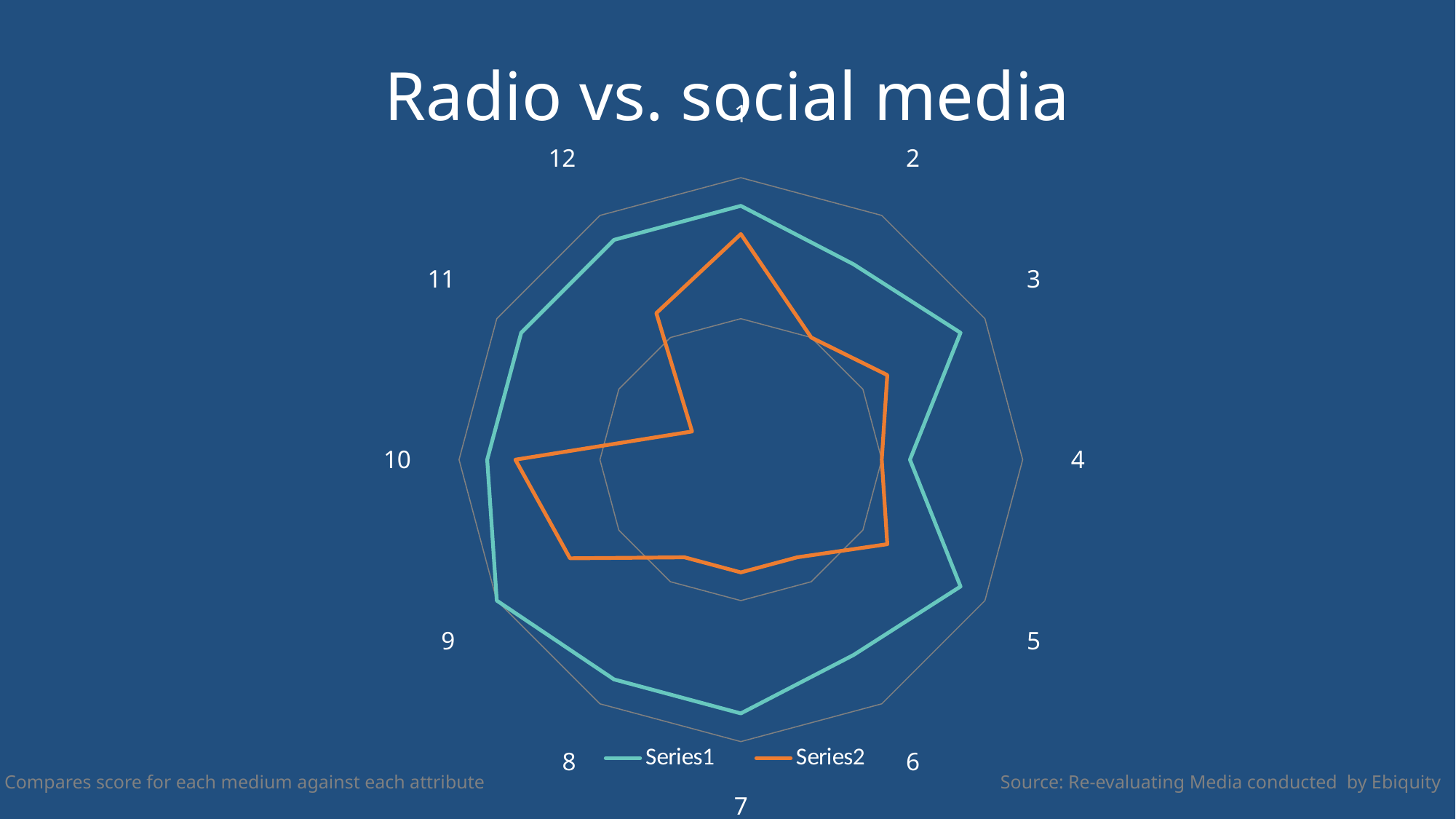
At category 7, which series has the larger value, Series1 or Series2? Series1 Which series has the larger values across all categories? Series1 How many series does the legend list? 2 How many categories (axes) does the radar chart have? 12 What is the title of the chart? Radio vs. social media Which category has the lowest value for Series2? 11 What are the two entries in the legend? Series1 and Series2 What kind of chart is shown on the slide? Radar chart At category 6, which series has the larger value, Series1 or Series2? Series1 Which category has the lowest value for Series1? 4